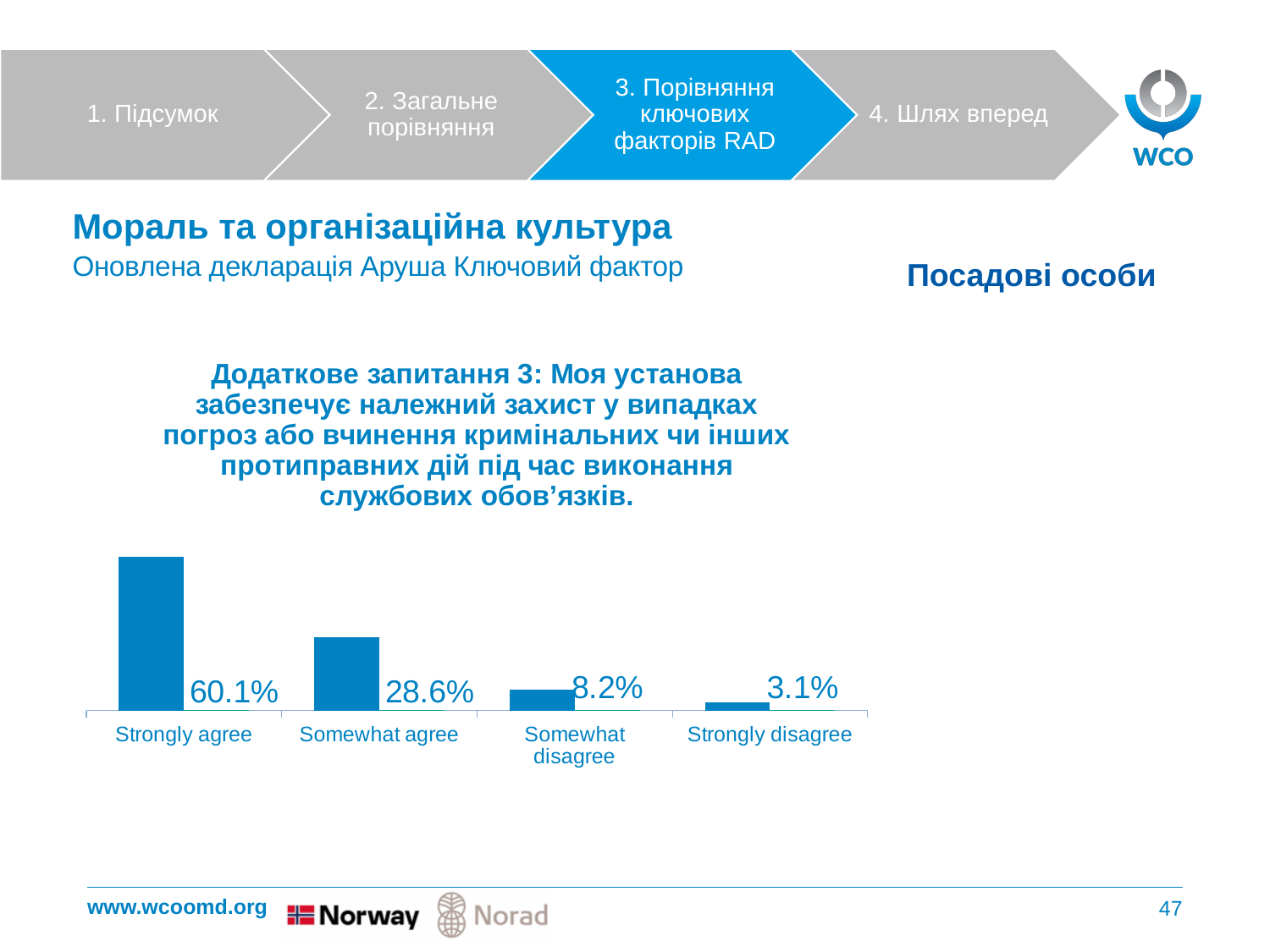
What is the difference between the values for Strongly agree and Somewhat agree? 31.5% What is the value for Somewhat disagree? 8.2% What kind of chart is shown on the slide? Bar chart What is the difference between the values for Somewhat disagree and Strongly disagree? 5.1% Which is larger, the value for Somewhat agree or the value for Somewhat disagree? Somewhat agree Do the values rise or fall from left to right along the x axis? Fall Which category has the highest value? Strongly agree What is the value for Strongly disagree? 3.1% What is the value for Strongly agree? 60.1% What is the value for Somewhat agree? 28.6% How many categories are shown in the chart? 4 Which category has the lowest value? Strongly disagree